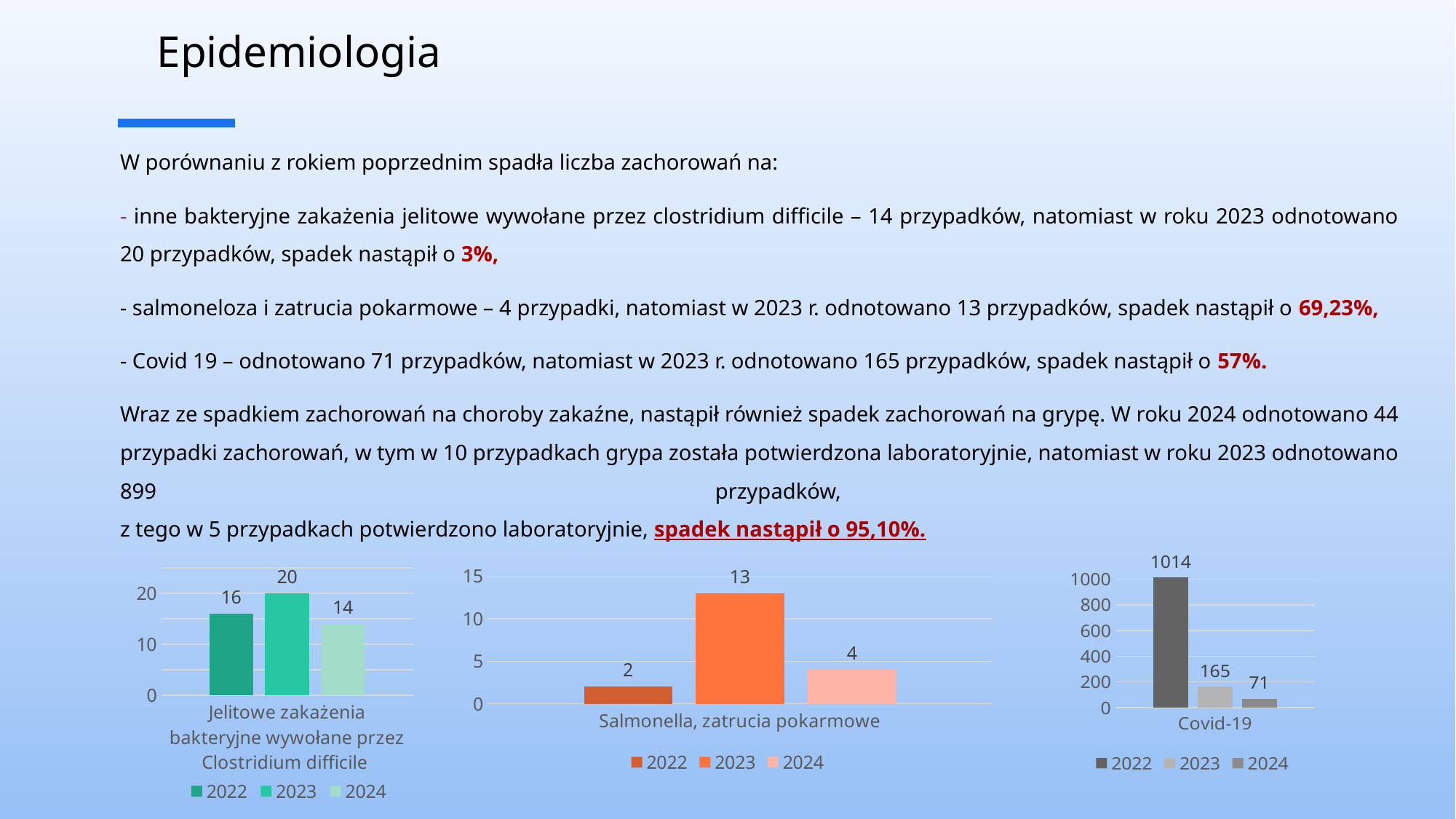
In the right chart (Covid-19), what is the difference between the 2023 and 2024 values? 94 In the right chart (Covid-19), what is the value for 2022? 1014 In the middle chart (Salmonella, zatrucia pokarmowe), which year has the highest value? 2023 In the middle chart (Salmonella, zatrucia pokarmowe), what is the value for 2022? 2 In the left chart (Clostridium difficile), what is the difference between the 2023 and 2024 values? 6 In the middle chart (Salmonella, zatrucia pokarmowe), which is larger, the value for 2022 or the value for 2024? 2024 What kind of chart is the middle chart (Salmonella, zatrucia pokarmowe)? bar chart In the left chart (Clostridium difficile), is the value for 2022 greater or less than 10? greater In the left chart (Clostridium difficile), which year has the lowest value? 2024 How many series does the legend of the right chart (Covid-19) list? 3 In the left chart (Jelitowe zakażenia bakteryjne wywołane przez Clostridium difficile), what is the value for 2023? 20 In the right chart (Covid-19), do the values rise or fall from 2022 to 2024? fall